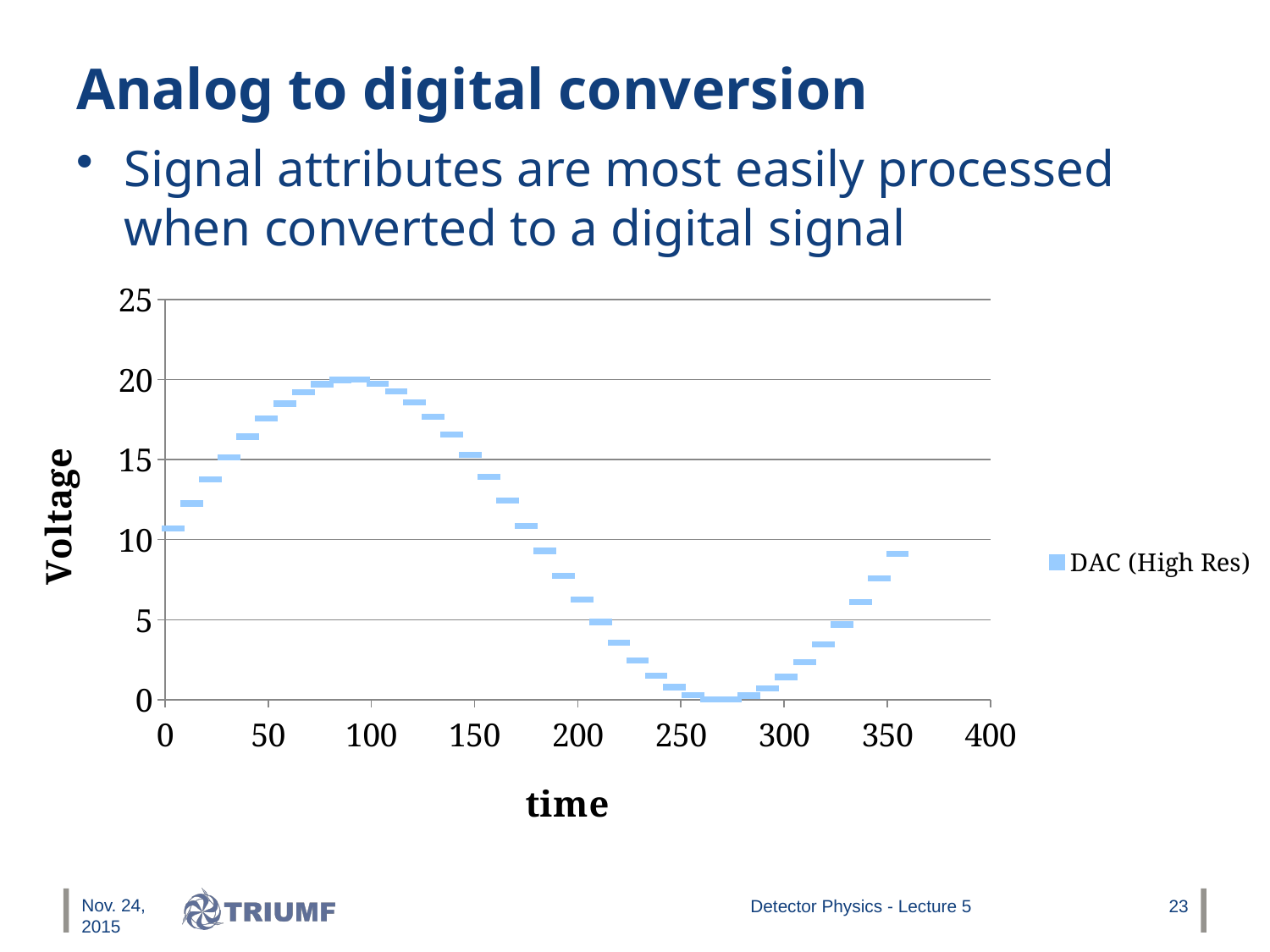
What is the label of the vertical axis? Voltage Do the DAC (High Res) values rise or fall between time 100 and time 250? fall Is the value for DAC (High Res) at time 250 greater or less than 5? less What kind of chart is shown on the slide? scatter chart Is the value for DAC (High Res) at time 50 greater or less than 15? greater Which is larger, the DAC (High Res) value at time 100 or at time 300? time 100 What is the name of the series shown in the legend? DAC (High Res) Is the lowest value of DAC (High Res) greater or less than 5? less How many series does the legend list? 1